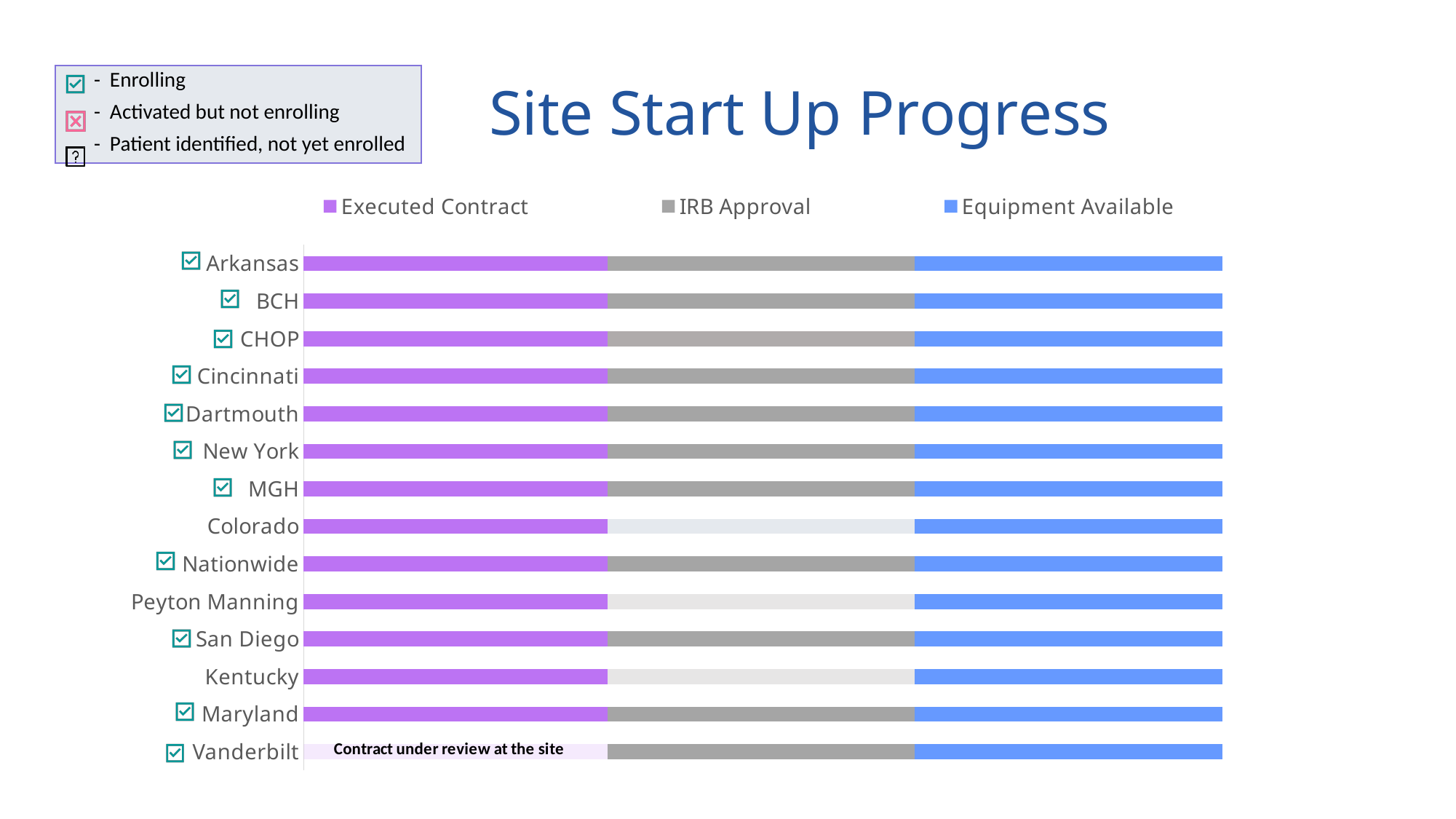
How many sites are listed on the chart? 14 Which site is the first (top) category on the chart? Arkansas What kind of chart is shown on the slide? Stacked bar chart Which sites have a light grey IRB Approval segment instead of a solid grey one? Colorado, Peyton Manning, Kentucky Which series is shown in purple in the legend? Executed Contract Which site is the last (bottom) category on the chart? Vanderbilt How many sites have a light grey (not solid grey) IRB Approval segment? 3 What text is written on the Executed Contract segment of the Vanderbilt bar? Contract under review at the site Which site's Executed Contract segment is not filled in solid purple? Vanderbilt What is the title of the chart? Site Start Up Progress How many series does the chart legend list? 3